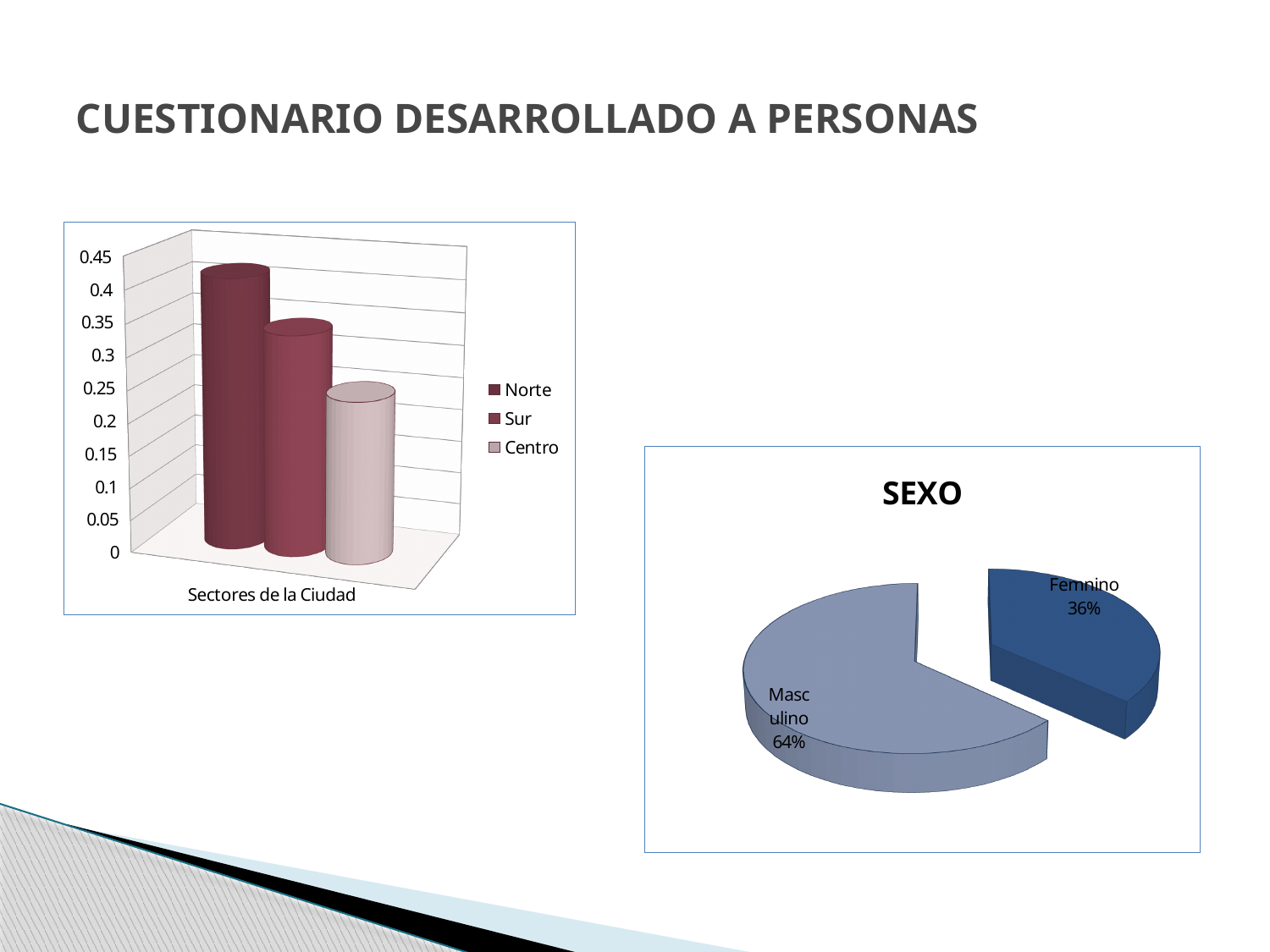
In the pie chart titled SEXO, what share is Masculino? 64% In the left bar chart, which series has the lowest value? Centro In the left bar chart, is the value for Norte greater or less than 0.3? greater In the left bar chart, which is larger, the value for Norte or the value for Centro? Norte In the left bar chart, how many series does the legend list? 3 In the pie chart titled SEXO, how many slices are there? 2 In the left bar chart, which series has the highest value? Norte What kind of chart is the chart titled SEXO? pie chart In the left bar chart, what is the label on the horizontal axis? Sectores de la Ciudad In the left bar chart, is the value for Centro greater or less than 0.3? less What kind of chart is the chart on the left of the slide? bar chart In the pie chart titled SEXO, what share is Femnino? 36%